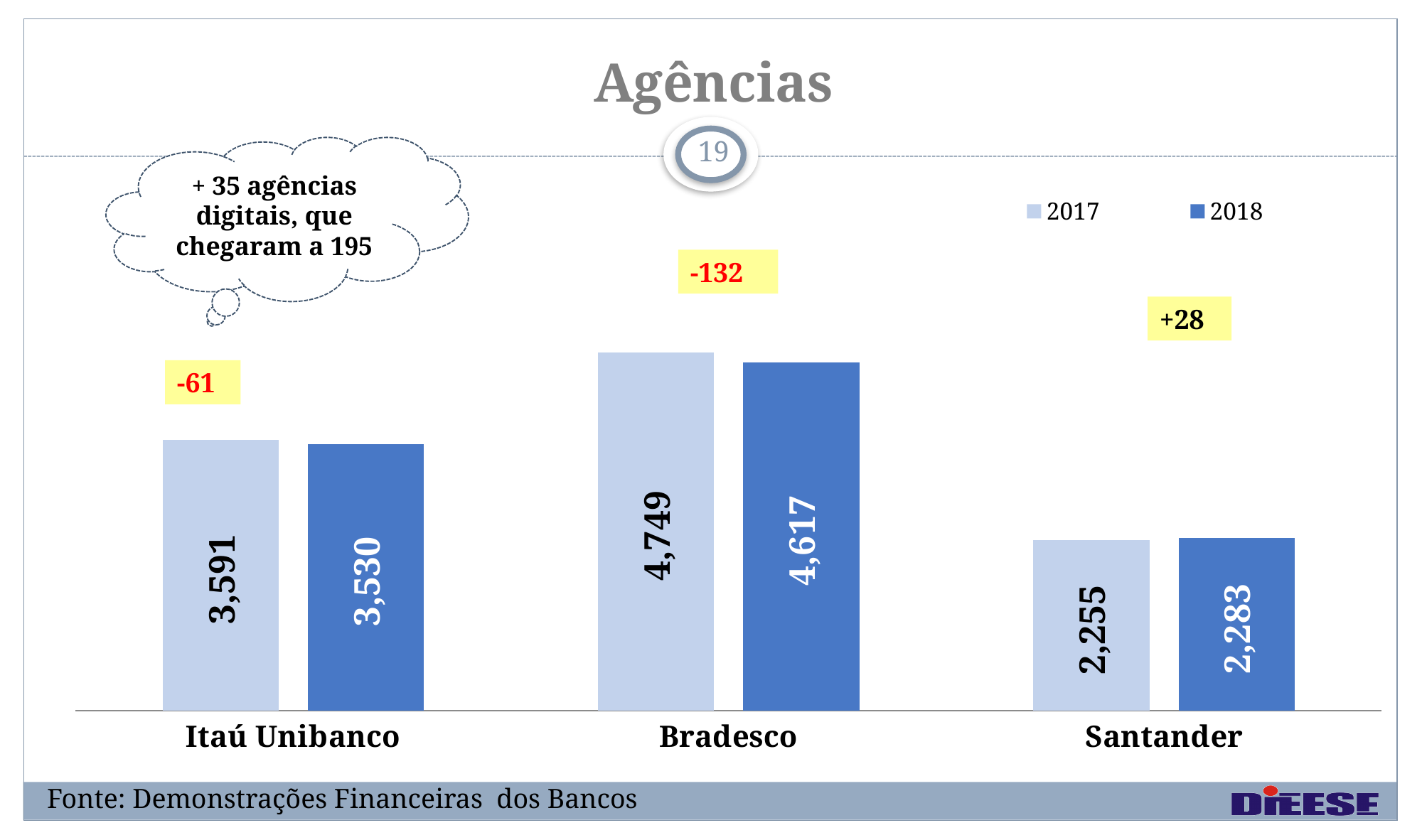
What is the title of the chart? Agências How many series does the legend list? 2 What kind of chart is shown on the slide? Bar chart Which is larger for Santander: the 2017 value or the 2018 value? 2018 What is the number of agências for Bradesco in 2018? 4,617 What is the difference between Bradesco's 2017 and 2018 agências values? 132 What is the number of agências for Itaú Unibanco in 2017? 3,591 How many banks are shown on the x axis of the chart? 3 Which bank has the highest number of agências in 2018? Bradesco What is the number of agências for Santander in 2017? 2,255 What is the difference between Itaú Unibanco's and Santander's 2018 agências values? 1,247 Which bank has the lowest number of agências in 2017? Santander